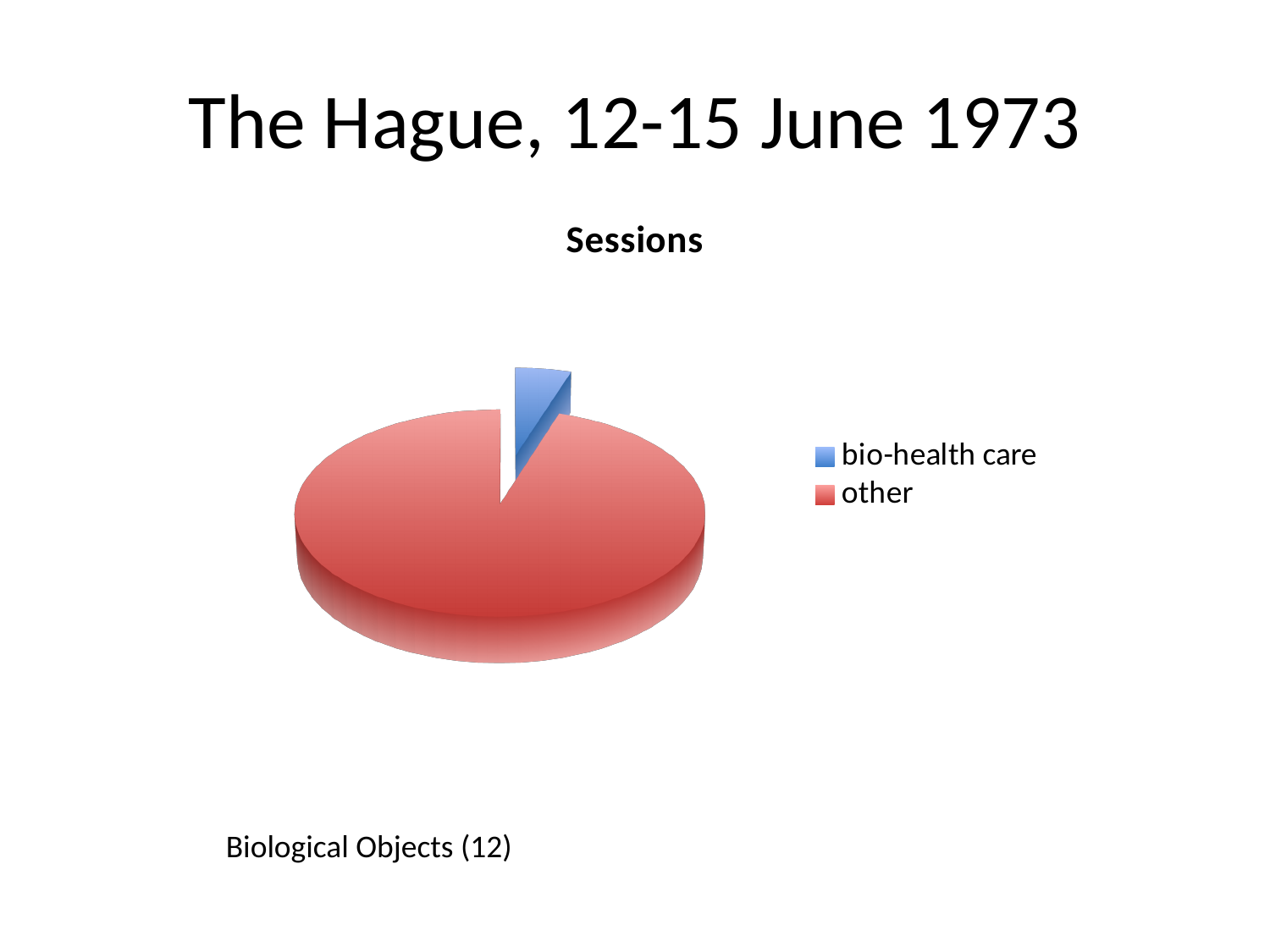
Which slice of the pie is the smallest? bio-health care What kind of chart is shown on the slide? pie chart What colour is the bio-health care slice? blue Which slice of the pie is the largest? other How many series does the legend list? 2 How many slices does the pie chart have? 2 What is the title of the chart? Sessions Which slice is larger, bio-health care or other? other